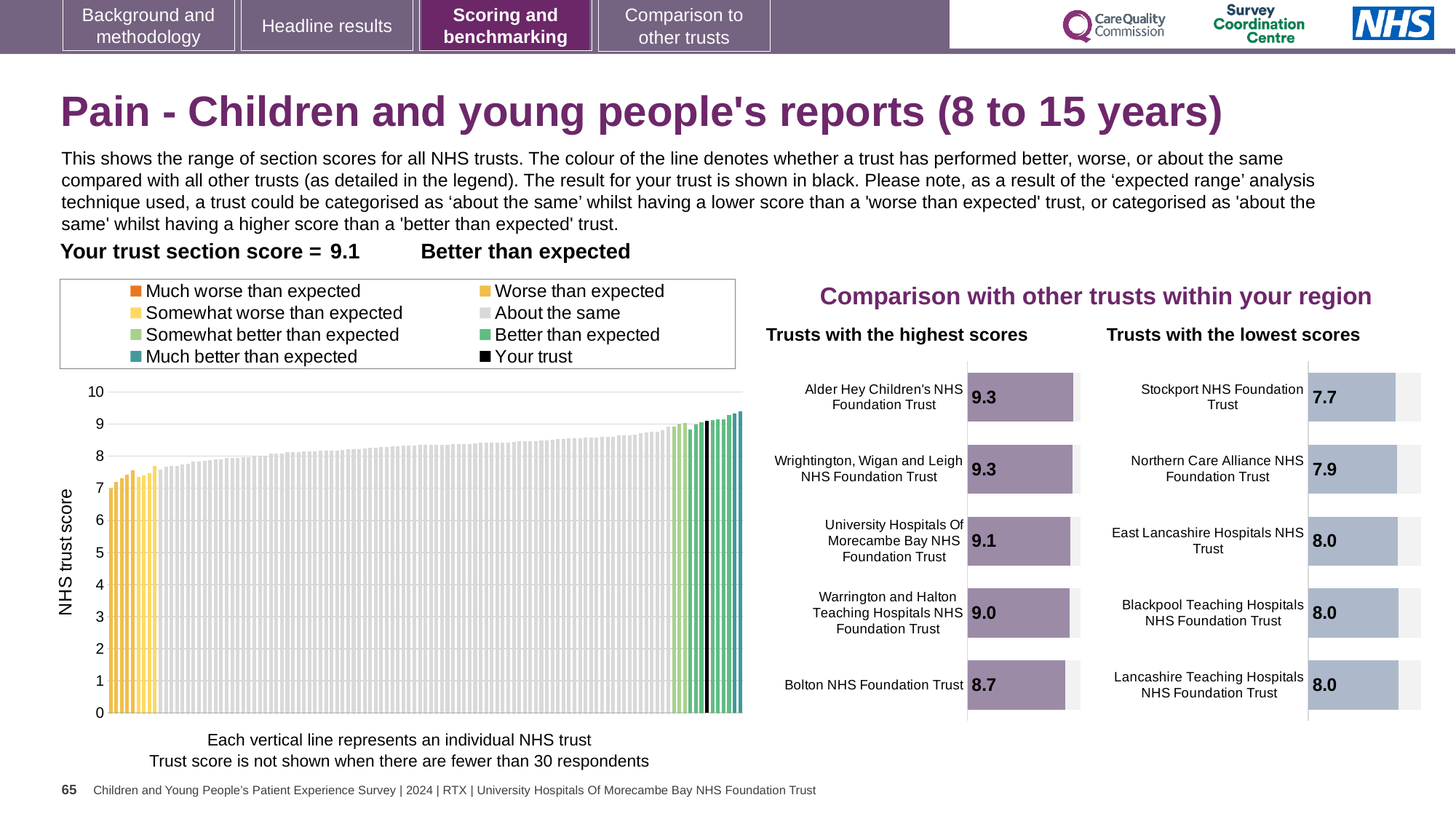
In the 'Trusts with the lowest scores' chart, what is the score for Stockport NHS Foundation Trust? 7.7 How many entries does the legend above the 'NHS trust score' chart list? 8 In the 'NHS trust score' chart on the left, what colour is the line for 'Your trust'? Black In the 'Trusts with the highest scores' chart, what is the difference between the scores of Alder Hey Children's NHS Foundation Trust and Bolton NHS Foundation Trust? 0.6 In the 'Trusts with the highest scores' chart, which trust has the lowest score? Bolton NHS Foundation Trust In the 'Trusts with the lowest scores' chart, which trust has the lowest score? Stockport NHS Foundation Trust In the 'Trusts with the lowest scores' chart, what is the difference between the scores of Lancashire Teaching Hospitals NHS Foundation Trust and Stockport NHS Foundation Trust? 0.3 How many trusts are shown in the 'Trusts with the highest scores' chart? 5 Which has the higher score: Warrington and Halton Teaching Hospitals NHS Foundation Trust in the highest scores chart, or Northern Care Alliance NHS Foundation Trust in the lowest scores chart? Warrington and Halton Teaching Hospitals NHS Foundation Trust In the 'Trusts with the highest scores' chart, what is the score for Bolton NHS Foundation Trust? 8.7 What kind of chart is the 'NHS trust score' chart on the left of the slide? Bar chart In the 'NHS trust score' chart on the left, do the values rise or fall from left to right? Rise